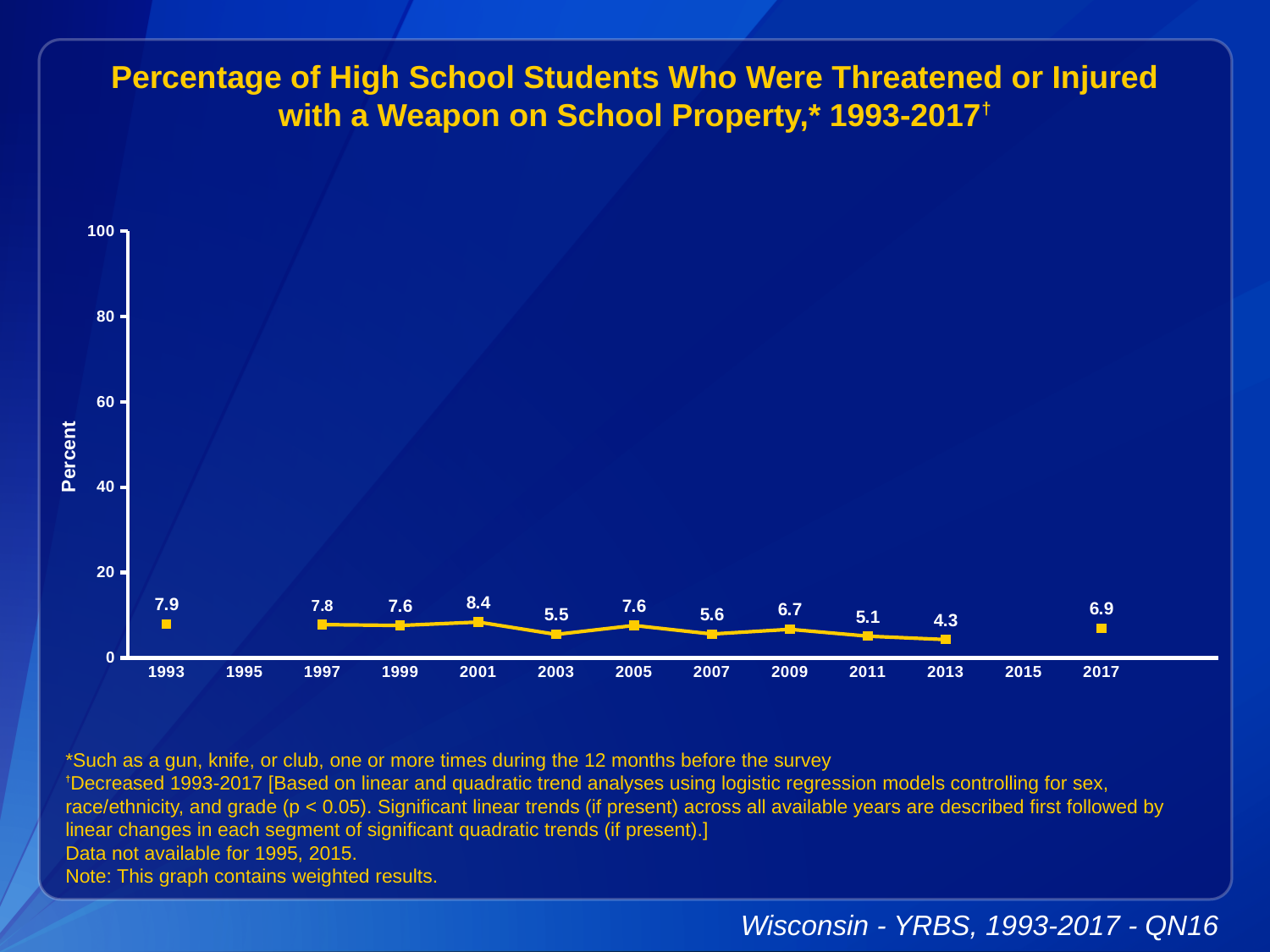
Is the value for 2005 greater or less than 20? less What is the value plotted for 2013? 4.3 Did the plotted value rise or fall from 2011 to 2013? fall What is the difference between the values for 2001 and 2013? 4.1 Which year has the lowest plotted value? 2013 What is the label on the vertical axis of the chart? Percent What kind of chart is shown on the slide? line chart Which year has the highest plotted value? 2001 What is the value plotted for 2017? 6.9 How many years have a data point plotted on the chart? 11 Which year has the larger value, 2009 or 2011? 2009 What percentage of high school students were threatened or injured with a weapon on school property in 1993? 7.9